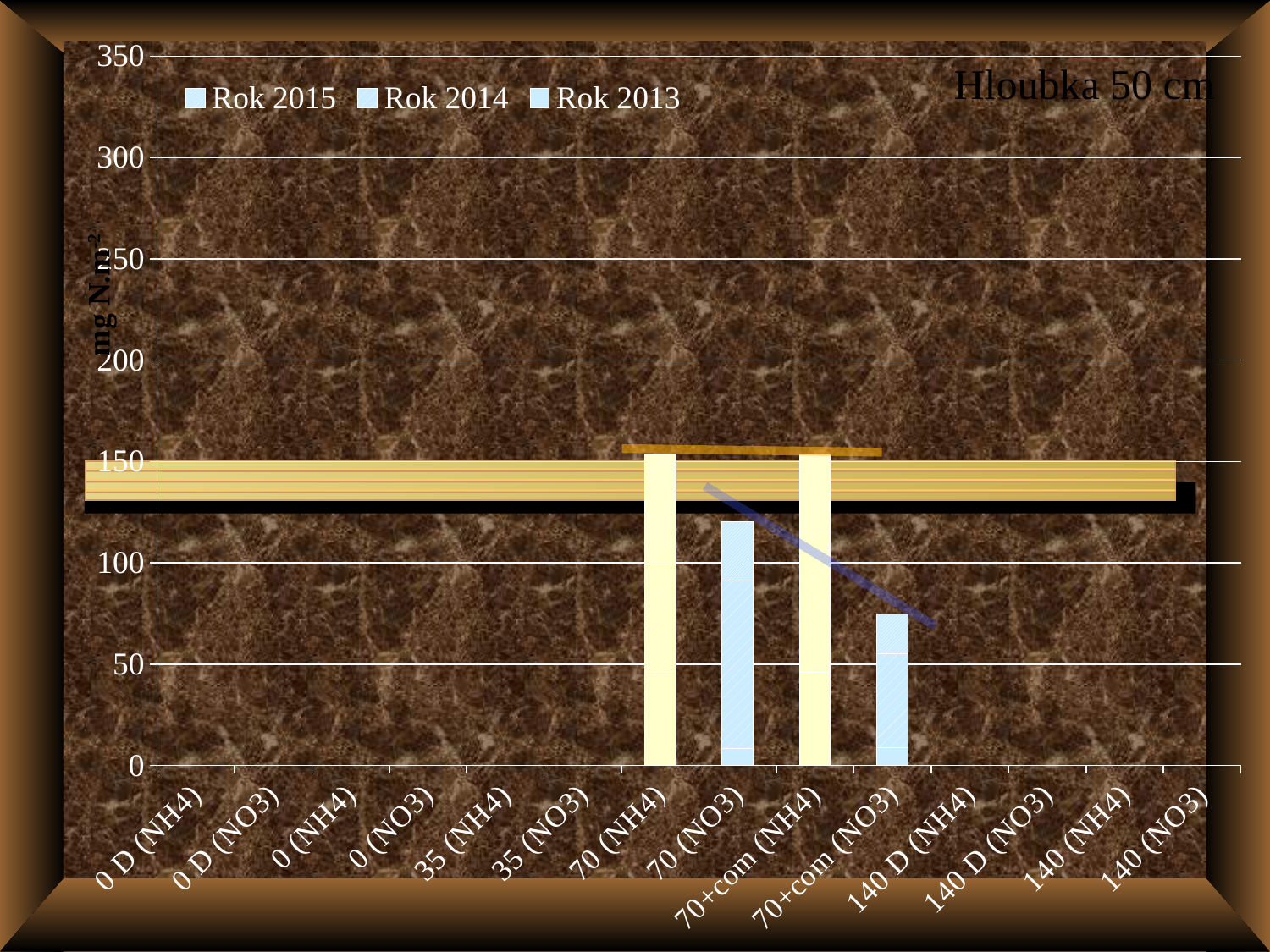
How many categories are shown on the x axis? 14 Is the value for 70 (NO3) greater or less than 100? greater What kind of chart is shown on the slide? bar chart Is the value for 70+com (NO3) greater or less than 50? greater Is the value for 70 (NH4) greater or less than 100? greater Which is larger, the value for 70 (NO3) or the value for 70+com (NO3)? 70 (NO3) Which is larger, the value for 70 (NH4) or the value for 70 (NO3)? 70 (NH4) Which series are listed in the legend? Rok 2015, Rok 2014, Rok 2013 How many series does the legend list? 3 What is the title shown in the top right of the chart? Hloubka 50 cm